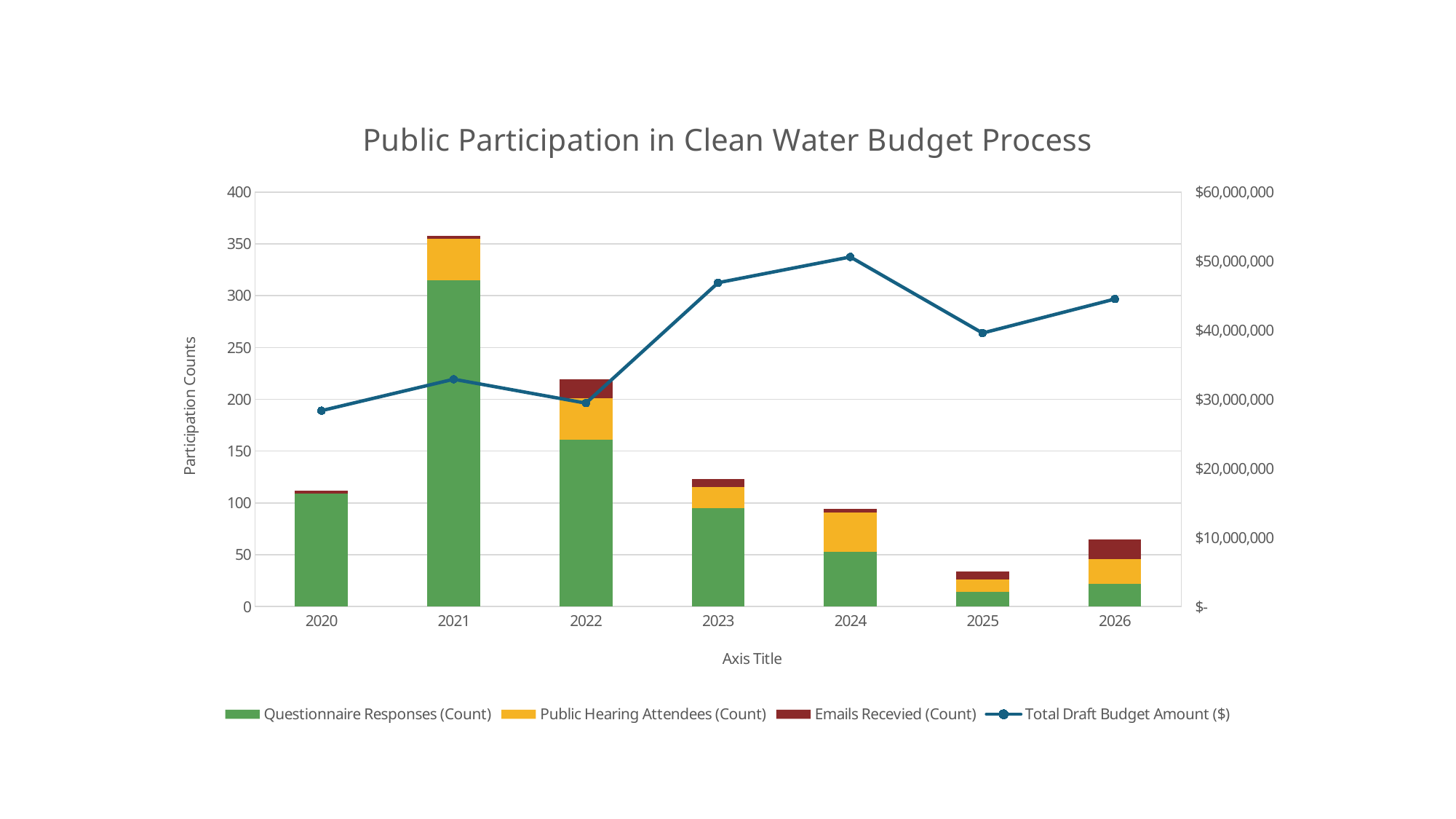
Is the Total Draft Budget Amount ($) for 2023 greater or less than $40,000,000? greater Which year has the larger total stacked bar, 2022 or 2023? 2022 Is the value for Questionnaire Responses (Count) in 2021 greater or less than 300? greater Is the total stacked bar for 2020 greater or less than 150? less What is the title of the chart? Public Participation in Clean Water Budget Process In which year is the Total Draft Budget Amount ($) line at its highest? 2024 How many series does the legend list? 4 What kind of chart is shown on the slide? Stacked bar chart with a line How many years are shown on the x axis? 7 Which year has the tallest stacked bar of participation counts? 2021 In which year is the Total Draft Budget Amount ($) line at its lowest? 2020 Which year has the shortest stacked bar of participation counts? 2025